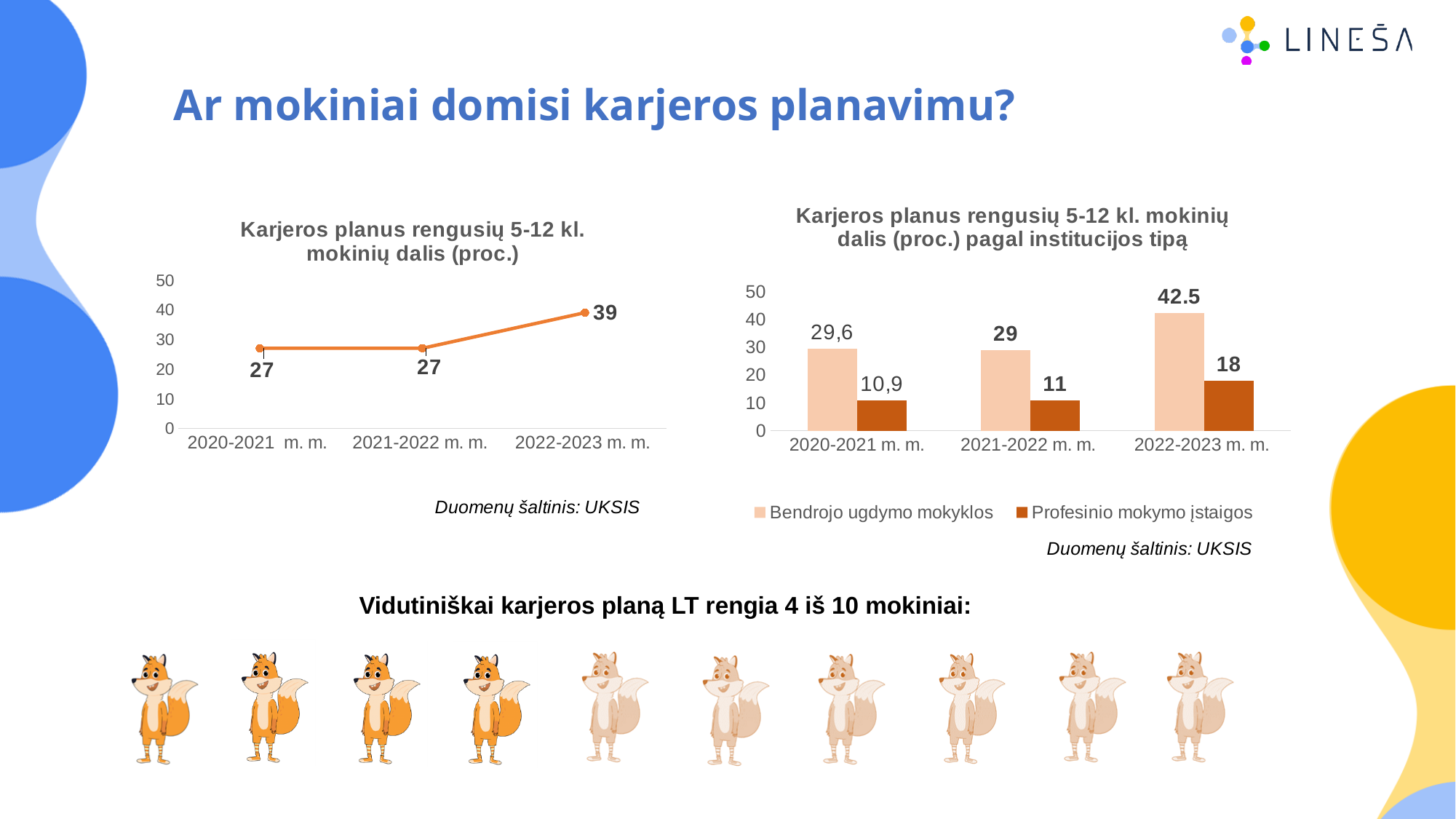
In the right chart (pagal institucijos tipą), what kind of chart is shown? bar chart In the left chart (Karjeros planus rengusių 5-12 kl. mokinių dalis), what is the value for 2020-2021 m. m.? 27 In the right chart (pagal institucijos tipą), what is the difference between Bendrojo ugdymo mokyklos and Profesinio mokymo įstaigos in 2021-2022 m. m.? 18 In the right chart (pagal institucijos tipą), how many series does the legend list? 2 In the right chart (pagal institucijos tipą), what is the value for Bendrojo ugdymo mokyklos in 2022-2023 m. m.? 42.5 In the right chart (pagal institucijos tipą), what is the value for Profesinio mokymo įstaigos in 2020-2021 m. m.? 10,9 In the left chart (Karjeros planus rengusių 5-12 kl. mokinių dalis), by how much did the value increase from 2021-2022 m. m. to 2022-2023 m. m.? 12 In the right chart (pagal institucijos tipą), which is larger in 2021-2022 m. m.: Bendrojo ugdymo mokyklos or Profesinio mokymo įstaigos? Bendrojo ugdymo mokyklos In the left chart (Karjeros planus rengusių 5-12 kl. mokinių dalis), what kind of chart is shown? line chart In the left chart (Karjeros planus rengusių 5-12 kl. mokinių dalis), how many school years are plotted? 3 In the left chart (Karjeros planus rengusių 5-12 kl. mokinių dalis), what is the value for 2022-2023 m. m.? 39 In the right chart (pagal institucijos tipą), which school year has the highest value for Profesinio mokymo įstaigos? 2022-2023 m. m.